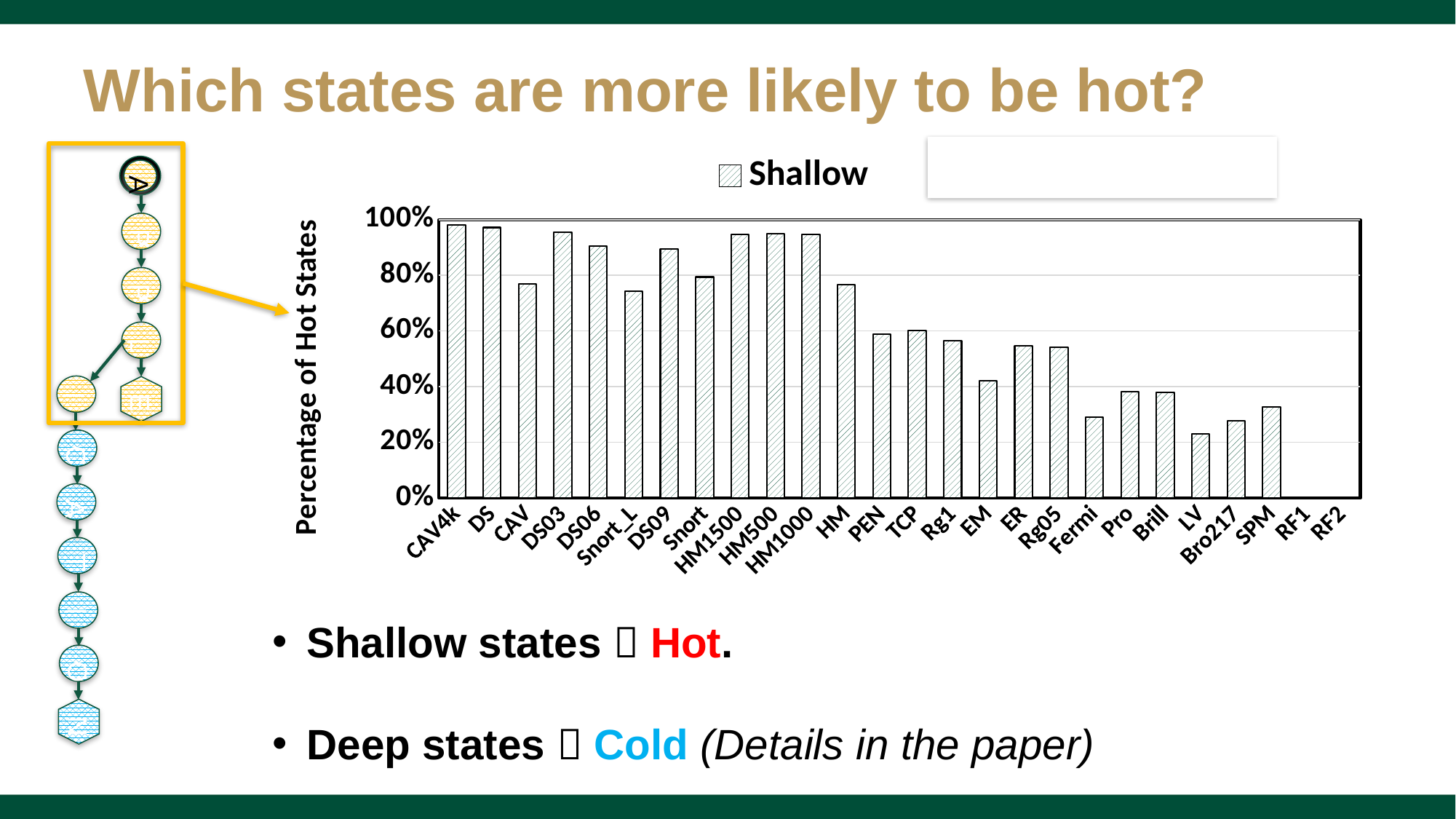
Which has a higher percentage of hot states, EM or Fermi? EM How many categories are shown on the x axis of the chart? 26 What kind of chart is shown on the slide? bar chart Which has a higher percentage of hot states, CAV4k or CAV? CAV4k What is the name of the series shown in the chart legend? Shallow Is the value for CAV greater or less than 80%? less What is the label of the y axis of the chart? Percentage of Hot States How many series does the chart legend list? 1 Is the value for LV greater or less than 20%? greater Do the values generally rise or fall moving from left to right along the x axis? fall Is the value for CAV4k greater or less than 80%? greater